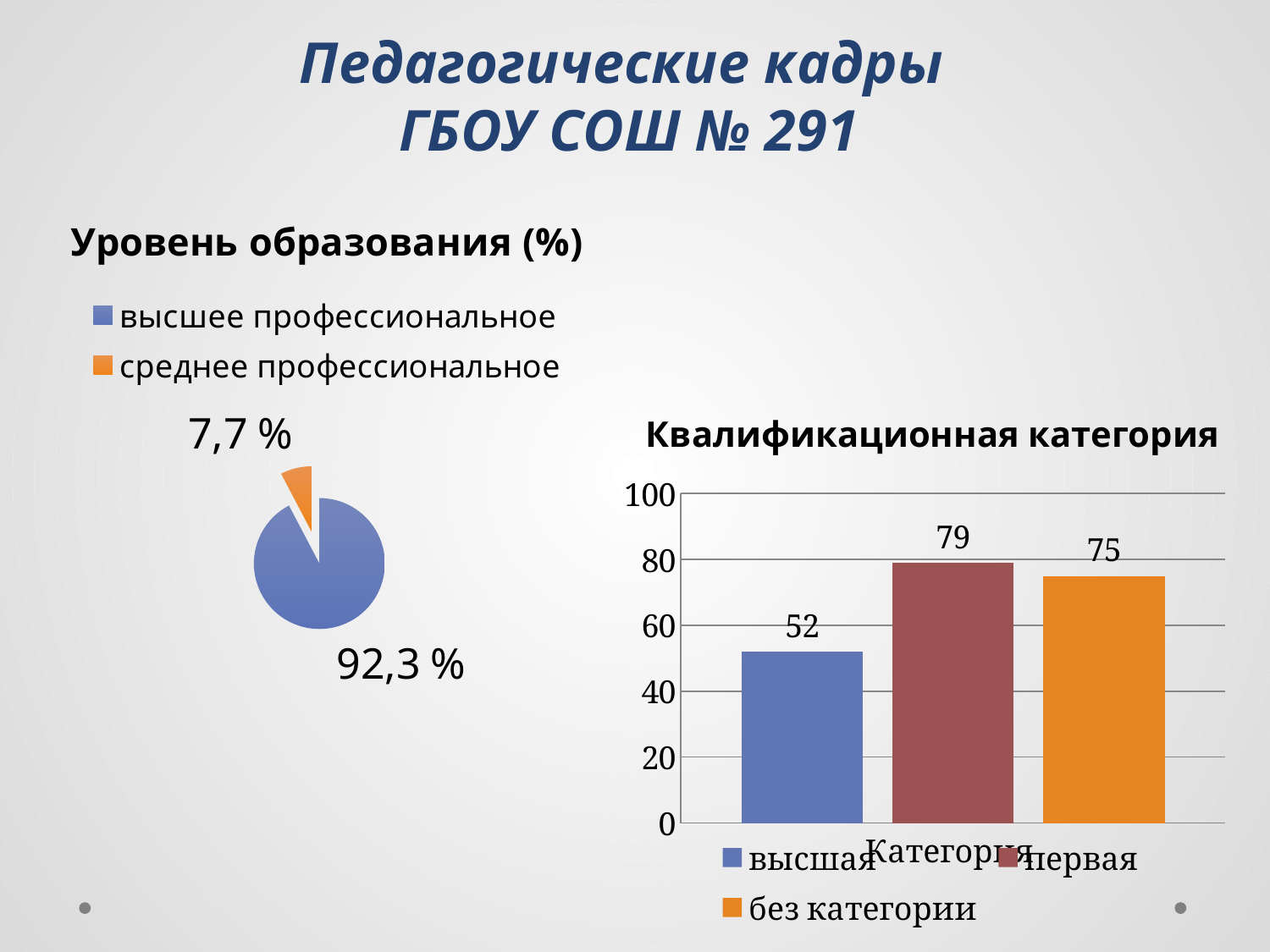
In the 'Квалификационная категория' chart, what is the value for без категории? 75 In the 'Квалификационная категория' chart, which category has the lowest value? высшая What kind of chart is 'Квалификационная категория'? Bar chart In the 'Уровень образования (%)' chart, what share is shown for высшее профессиональное? 92,3 % How many series does the legend of the 'Уровень образования (%)' chart list? 2 What kind of chart is 'Уровень образования (%)'? Pie chart In the 'Квалификационная категория' chart, which category has the highest value? первая In the 'Уровень образования (%)' chart, what share is shown for среднее профессиональное? 7,7 % In the 'Квалификационная категория' chart, what is the value for первая? 79 In the 'Квалификационная категория' chart, what is the difference between the values for первая and высшая? 27 In the 'Уровень образования (%)' chart, which category has the largest slice? высшее профессиональное In the 'Квалификационная категория' chart, what is the value for высшая? 52